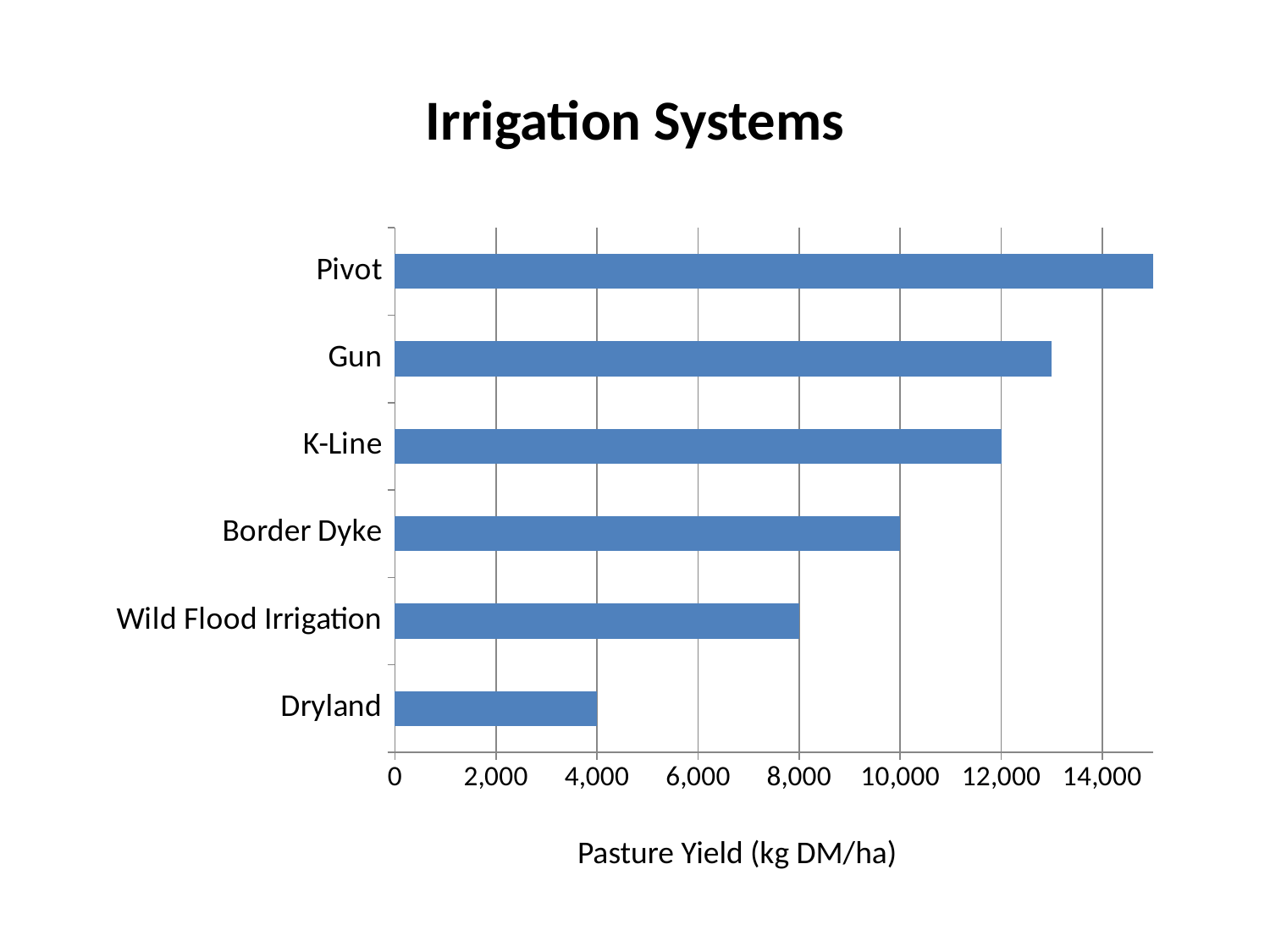
What type of chart is shown on the slide? bar chart Which irrigation system has the highest pasture yield? Pivot What is the difference in pasture yield between K-Line and Dryland? 8,000 Is the pasture yield for Gun greater or less than 12,000? greater How many irrigation systems are shown in the chart? 6 What is the pasture yield for Wild Flood Irrigation? 8,000 What is the pasture yield for Border Dyke? 10,000 What is the pasture yield for Dryland? 4,000 Which has a higher pasture yield, Gun or Border Dyke? Gun Is the pasture yield for Pivot greater or less than 14,000? greater Which category has the lowest pasture yield? Dryland What is the pasture yield for K-Line? 12,000